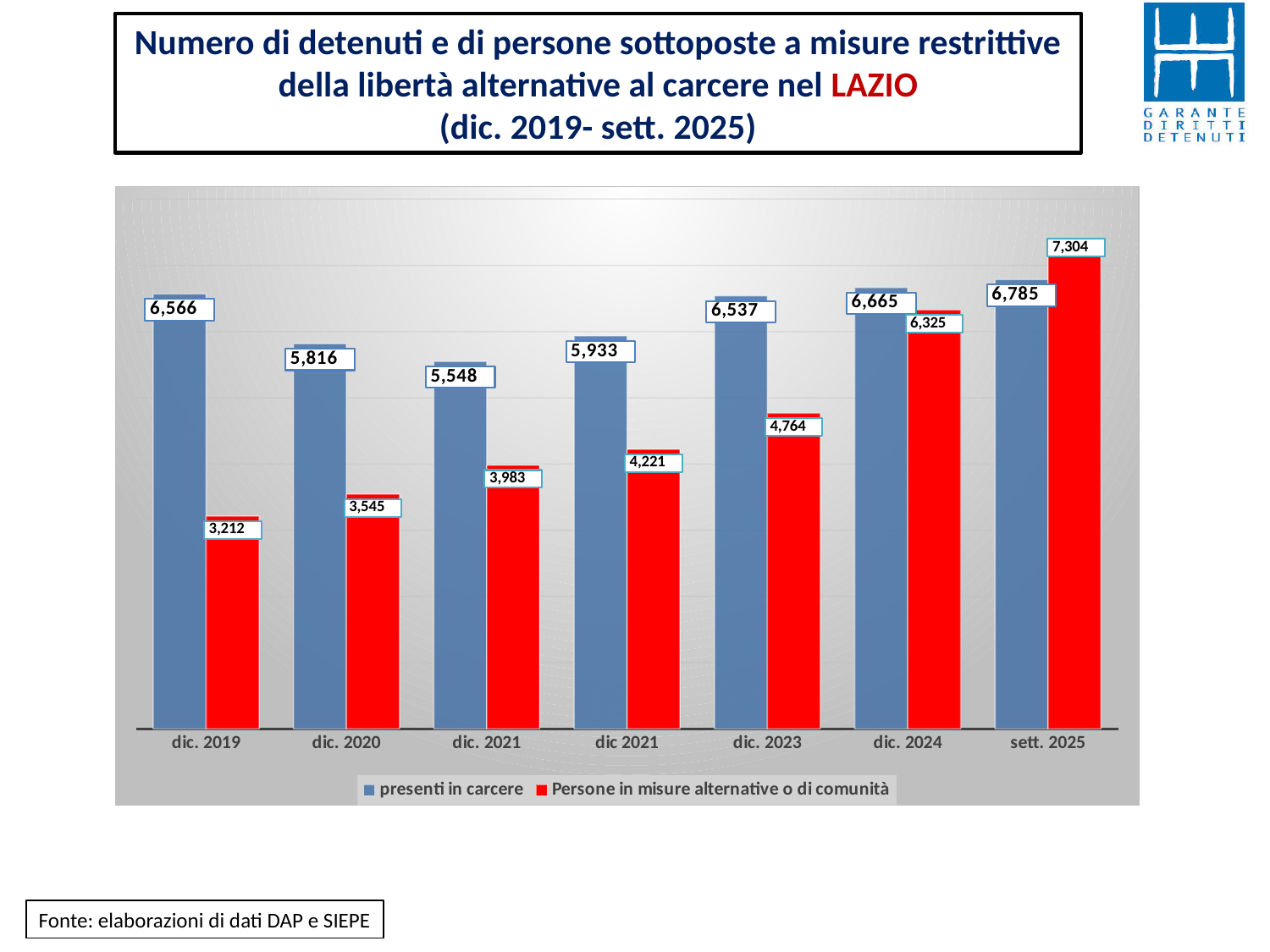
In sett. 2025, what is the difference between 'Persone in misure alternative o di comunità' and 'presenti in carcere'? 519 In which period is the 'presenti in carcere' value highest? sett. 2025 What kind of chart is shown on the slide? bar chart Do the values for 'Persone in misure alternative o di comunità' rise or fall from dic. 2019 to sett. 2025? rise What is the value for 'Persone in misure alternative o di comunità' in dic. 2023? 4,764 What is the value for 'presenti in carcere' in dic. 2019? 6,566 In which period is the 'Persone in misure alternative o di comunità' value lowest? dic. 2019 What is the difference between 'presenti in carcere' in dic. 2019 and in dic. 2020? 750 What is the value for 'Persone in misure alternative o di comunità' in sett. 2025? 7,304 How many periods are shown on the x axis? 7 How many series does the legend list? 2 In dic. 2024, which series has the larger value: 'presenti in carcere' or 'Persone in misure alternative o di comunità'? presenti in carcere